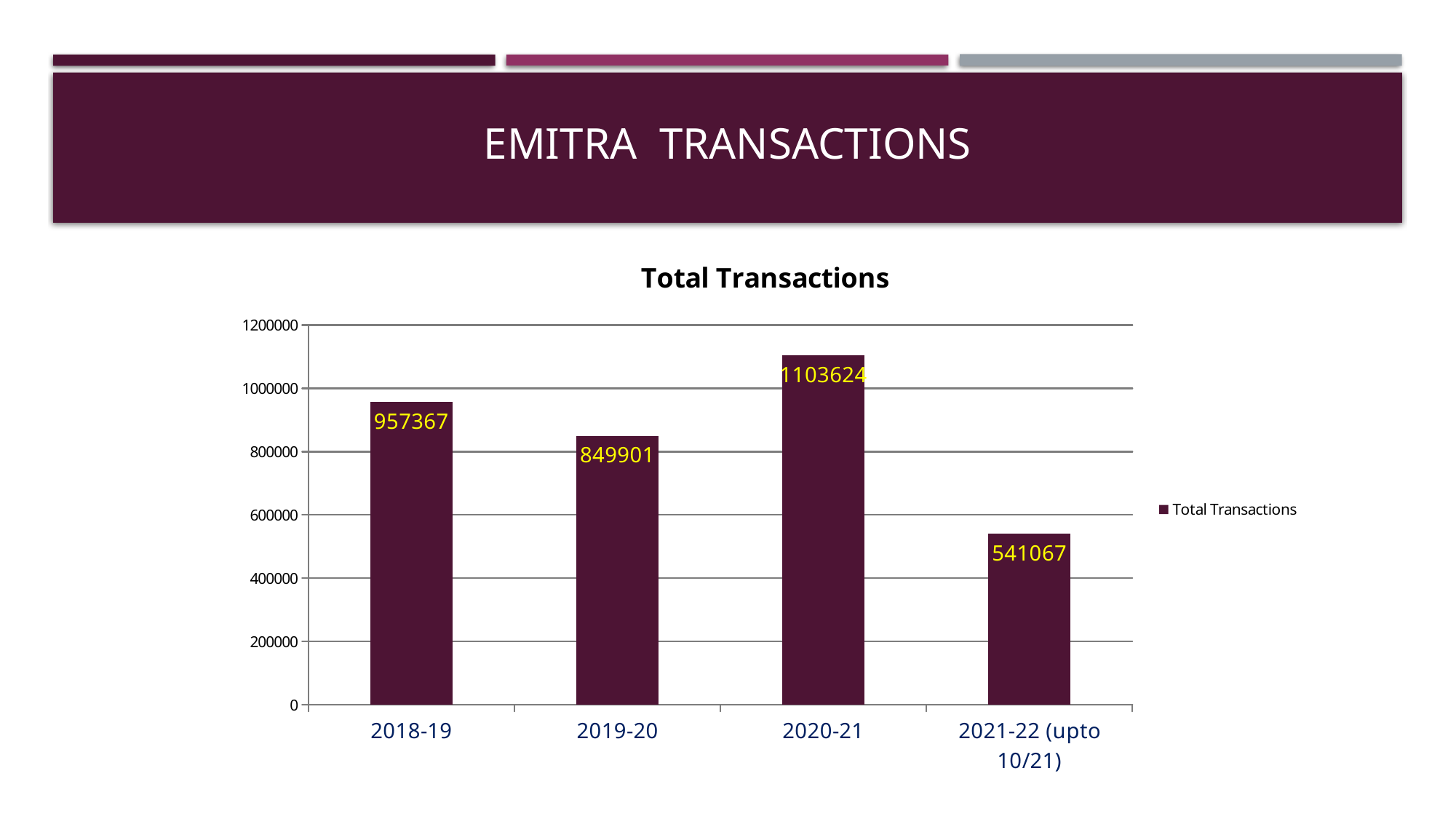
What is the difference between the values for 2020-21 and 2018-19? 146257 Which category has the highest value? 2020-21 Which is larger, the value for 2019-20 or the value for 2021-22 (upto 10/21)? 2019-20 How many categories are shown on the x axis? 4 What is the value for 2019-20? 849901 What is the value for 2021-22 (upto 10/21)? 541067 What is the difference between the values for 2018-19 and 2019-20? 107466 What is the value for 2018-19? 957367 What is the value for 2020-21? 1103624 What kind of chart is shown? bar chart Which category has the lowest value? 2021-22 (upto 10/21) What is the title of the chart? Total Transactions